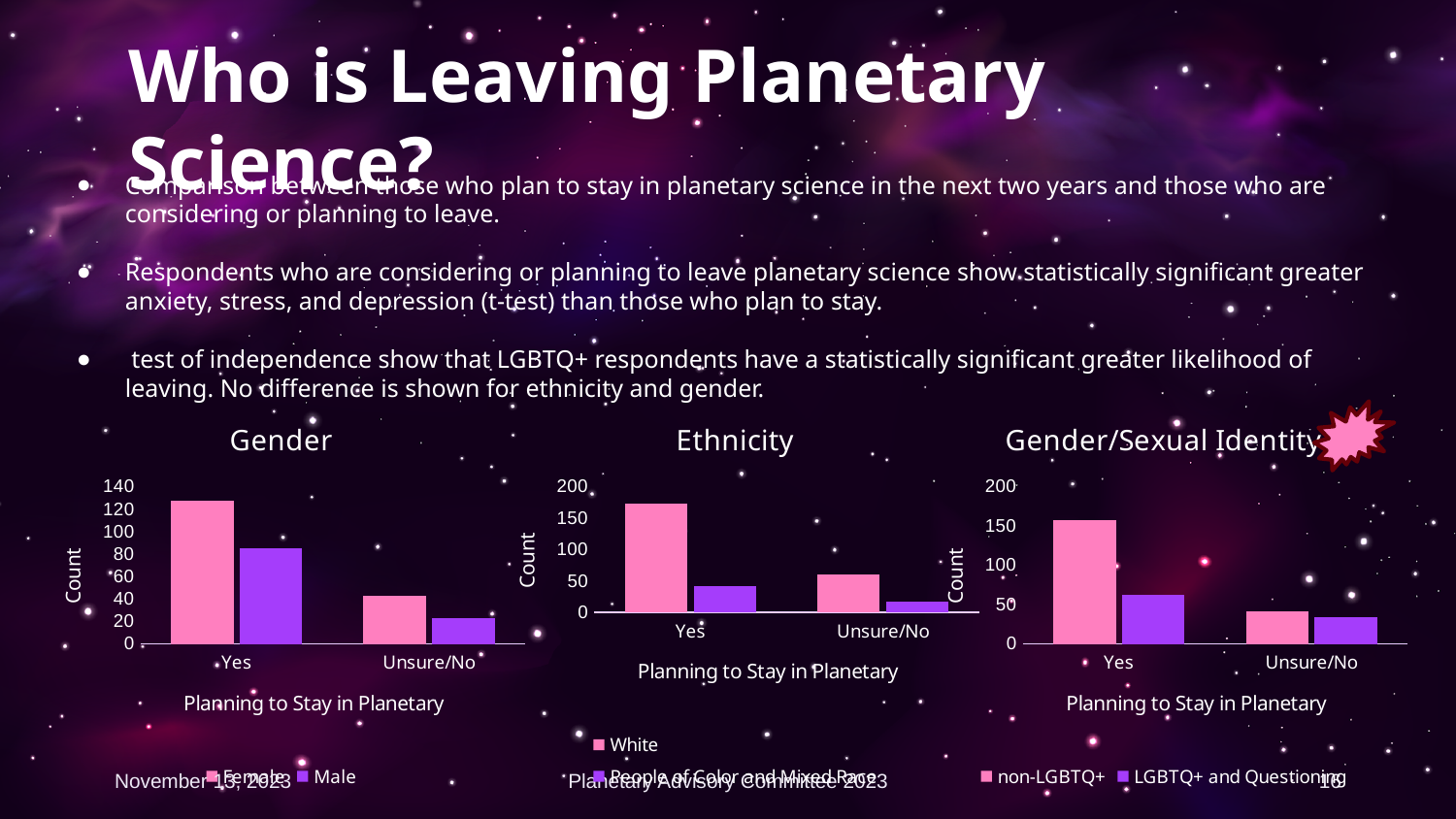
In the Ethnicity chart, which bar is the tallest? White, Yes In the Gender/Sexual Identity chart, what is the x-axis title? Planning to Stay in Planetary In the Gender/Sexual Identity chart, which series has the taller bar in the Yes category, non-LGBTQ+ or LGBTQ+ and Questioning? non-LGBTQ+ In the Gender chart, is the value for Female in the Yes category greater or less than 120? greater In the Gender chart, which series has the taller bar in the Yes category, Female or Male? Female In the Ethnicity chart, how many categories are shown on the x axis? 2 In the Gender chart, what kind of chart is shown? bar chart In the Ethnicity chart, is the value for People of Color and Mixed Race in the Unsure/No category greater or less than 50? less In the Gender chart, is the value for Male in the Unsure/No category greater or less than 40? less In the Gender chart, how many series does the legend list? 2